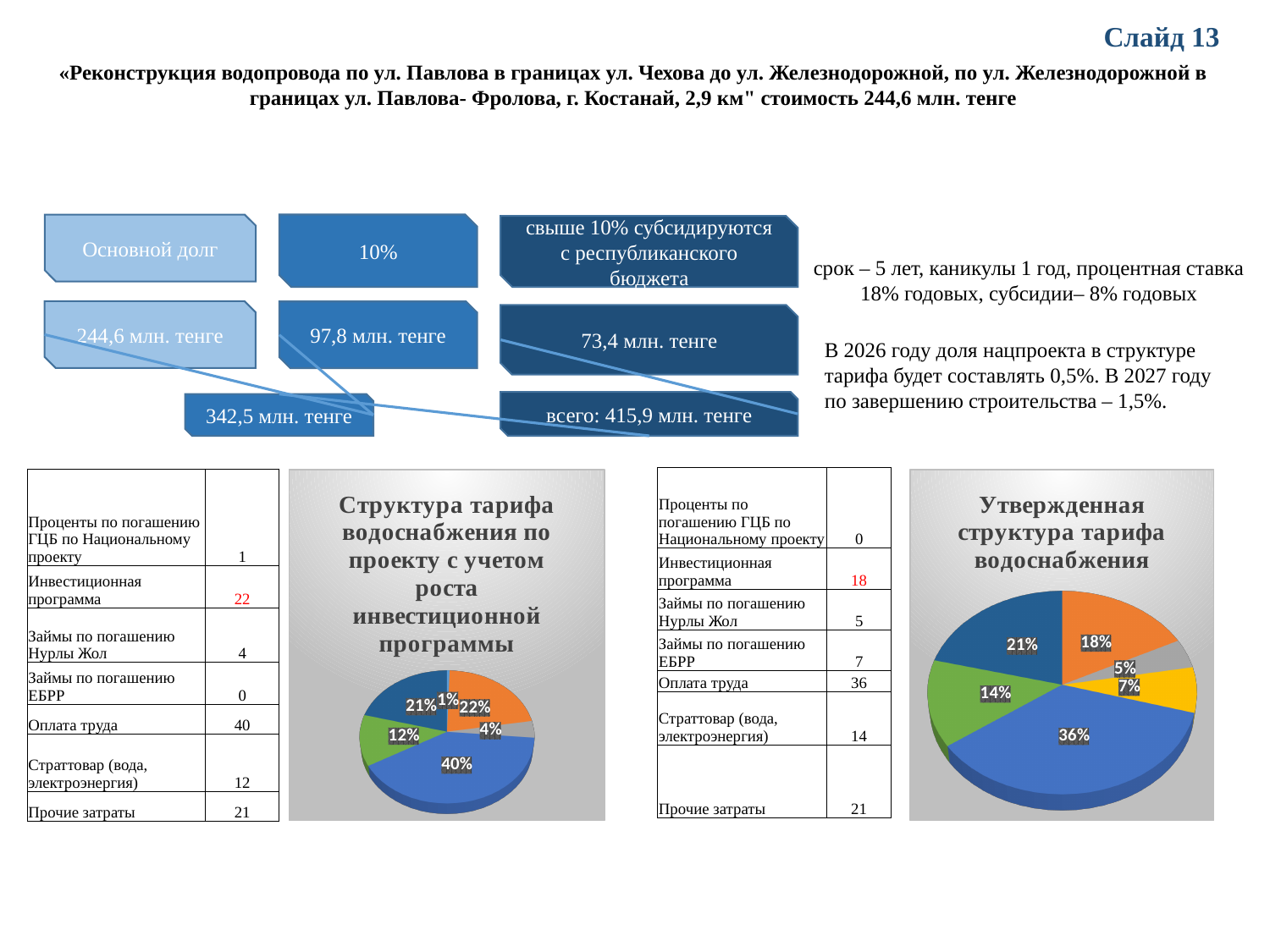
In the chart «Структура тарифа водоснабжения по проекту с учетом роста инвестиционной программы», what is the largest slice's share? 40% What kind of chart is the chart titled «Структура тарифа водоснабжения по проекту с учетом роста инвестиционной программы»? pie chart In the chart «Структура тарифа водоснабжения по проекту с учетом роста инвестиционной программы», which slice is larger: the one labelled 12% or the one labelled 21%? 21% In the chart «Утвержденная структура тарифа водоснабжения», what is the largest slice's share? 36% In the chart «Структура тарифа водоснабжения по проекту с учетом роста инвестиционной программы», what share does the slice for Инвестиционная программа have? 22% In the chart «Утвержденная структура тарифа водоснабжения», what is the smallest labelled slice's share? 5% In the chart «Утвержденная структура тарифа водоснабжения», how many slices are labelled with percentages? 6 In the chart «Структура тарифа водоснабжения по проекту с учетом роста инвестиционной программы», what is the smallest labelled slice's share? 1% In the chart «Утвержденная структура тарифа водоснабжения», what share does the slice for Оплата труда have? 36% In the chart «Утвержденная структура тарифа водоснабжения», what is the difference between the 36% slice and the 21% slice? 15% What kind of chart is the chart titled «Утвержденная структура тарифа водоснабжения»? pie chart What is the title of the pie chart on the right side of the slide? Утвержденная структура тарифа водоснабжения